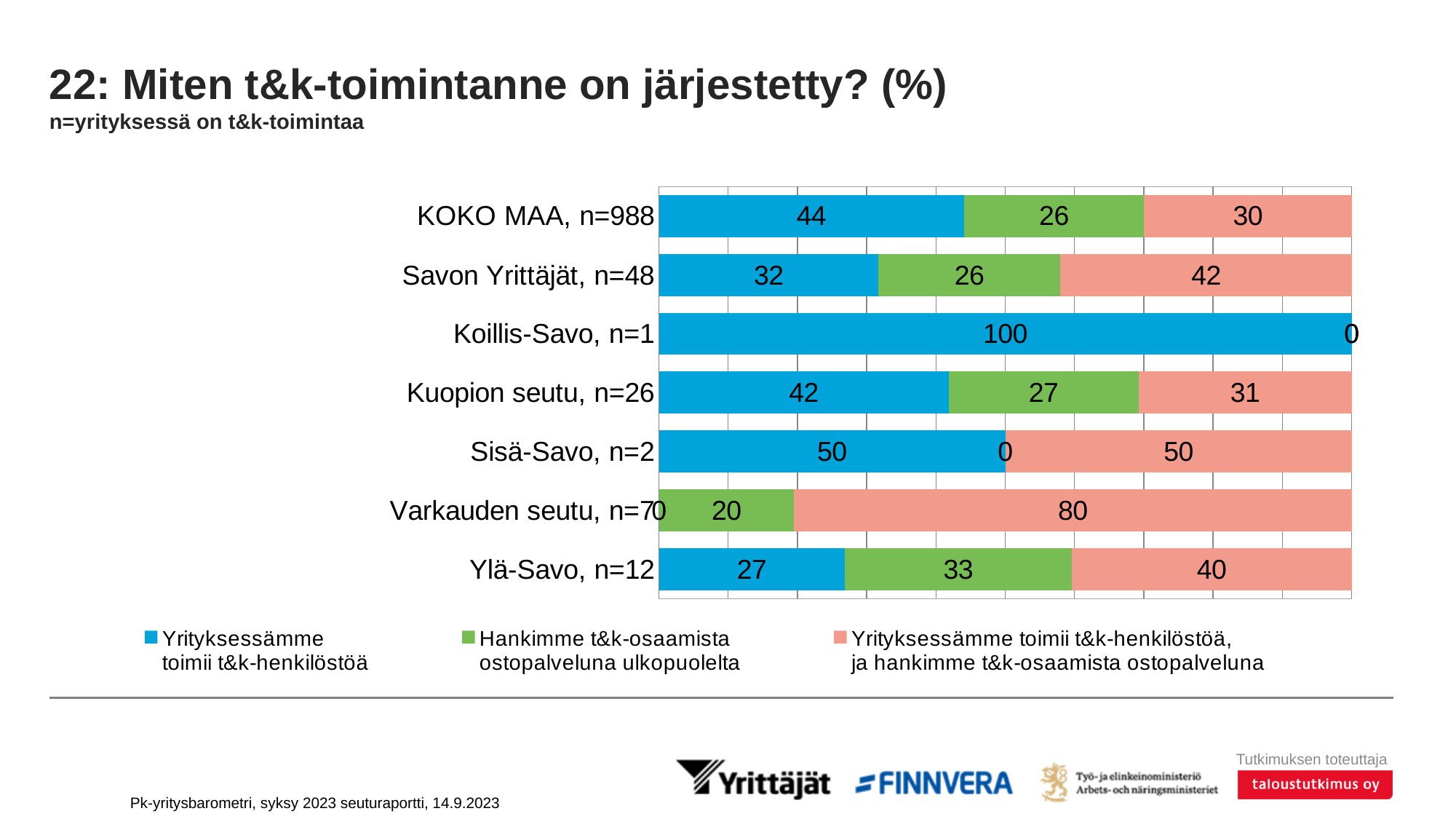
What is the value for "Yrityksessämme toimii t&k-henkilöstöä" for KOKO MAA, n=988? 44 What kind of chart is shown on the slide? Stacked bar chart What is the difference between the "Yrityksessämme toimii t&k-henkilöstöä" values for KOKO MAA, n=988 and Savon Yrittäjät, n=48? 12 What is the value for "Yrityksessämme toimii t&k-henkilöstöä, ja hankimme t&k-osaamista ostopalveluna" for Savon Yrittäjät, n=48? 42 Which category has the highest value for "Yrityksessämme toimii t&k-henkilöstöä, ja hankimme t&k-osaamista ostopalveluna"? Varkauden seutu How many series does the legend list? 3 Which is larger: the "Hankimme t&k-osaamista ostopalveluna ulkopuolelta" value for Kuopion seutu, n=26 or for Ylä-Savo, n=12? Ylä-Savo, n=12 What is the value for "Yrityksessämme toimii t&k-henkilöstöä" for Kuopion seutu, n=26? 42 How many categories are shown on the chart? 7 What is the value for "Hankimme t&k-osaamista ostopalveluna ulkopuolelta" for Ylä-Savo, n=12? 33 Which category has the highest value for "Yrityksessämme toimii t&k-henkilöstöä"? Koillis-Savo, n=1 What is the total of the stacked bar for Ylä-Savo, n=12? 100